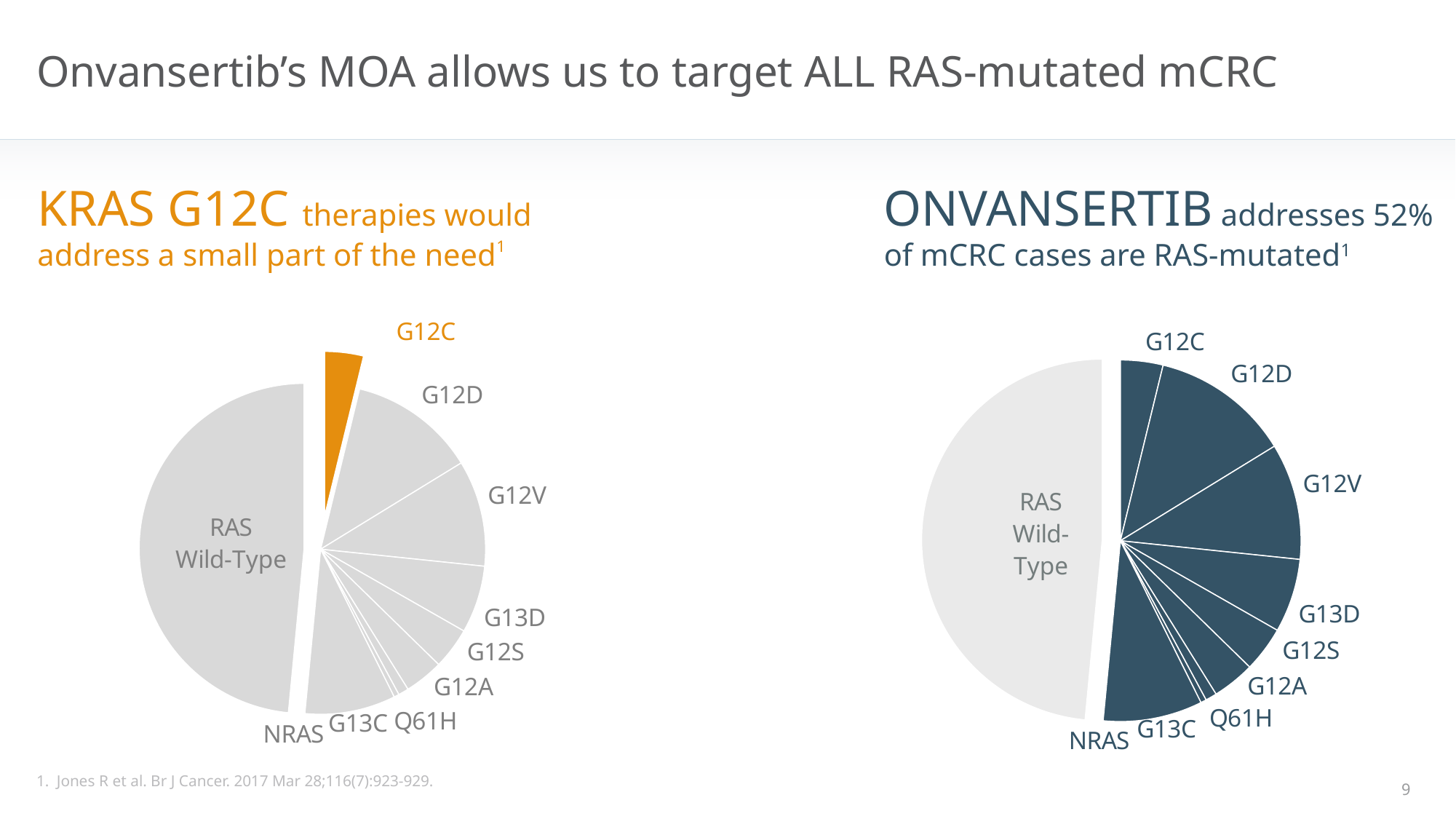
In the right pie chart, which slice is larger, RAS Wild-Type or G12V? RAS Wild-Type In the right pie chart, what colour are the RAS-mutated slices? Dark blue In the right pie chart, which is the largest of the mutation slices (excluding RAS Wild-Type)? G12D In the left pie chart, which slice is the largest? RAS Wild-Type How many slices does the left pie chart have? 10 In the left pie chart, which slice is larger, G12V or G12C? G12V How many slices does the right pie chart have? 10 What kind of chart is shown on the left side of the slide? Pie chart What kind of chart is shown on the right side of the slide? Pie chart According to the right-hand heading, what share of mCRC cases are RAS-mutated? 52% In the left pie chart, which slice is highlighted in orange? G12C In the right pie chart, which slice is larger, G12D or G12S? G12D